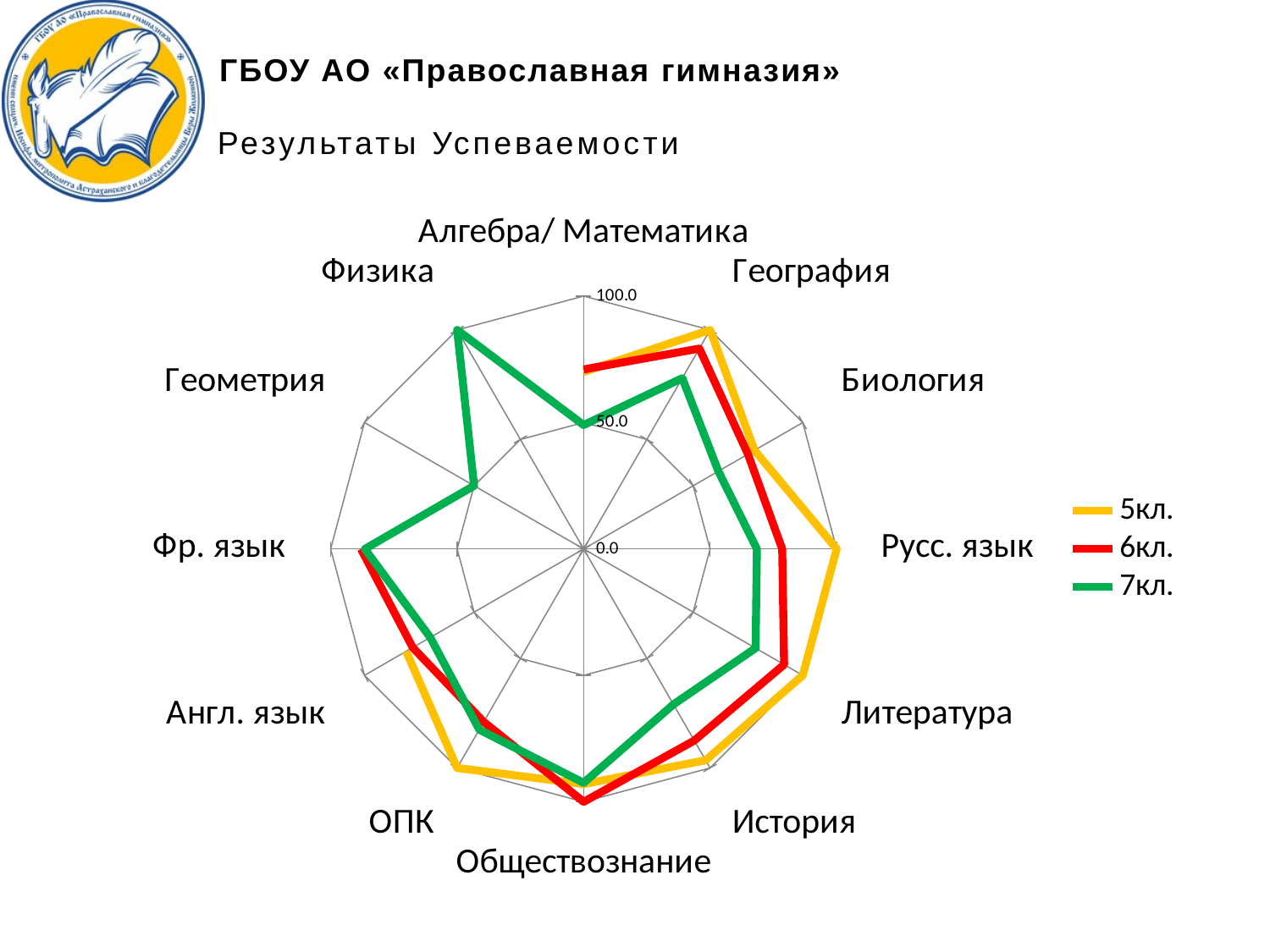
Is the value for 7кл. in Фр. язык greater or less than 50? greater For Литература, which is larger: the value for 5кл. or for 7кл.? 5кл. Is the value for 6кл. in Обществознание greater or less than 50? greater How many subject categories (axes) does the radar chart have? 12 Which series has the highest value for Русс. язык? 5кл. What is the maximum value shown on the radial axis? 100.0 How many series does the legend list? 3 Is the value for 7кл. in Русс. язык greater or less than 50? greater For Русс. язык, which is larger: the value for 5кл. or for 7кл.? 5кл. Which series are listed in the legend? 5кл., 6кл., 7кл. What kind of chart is shown on the slide? Radar chart